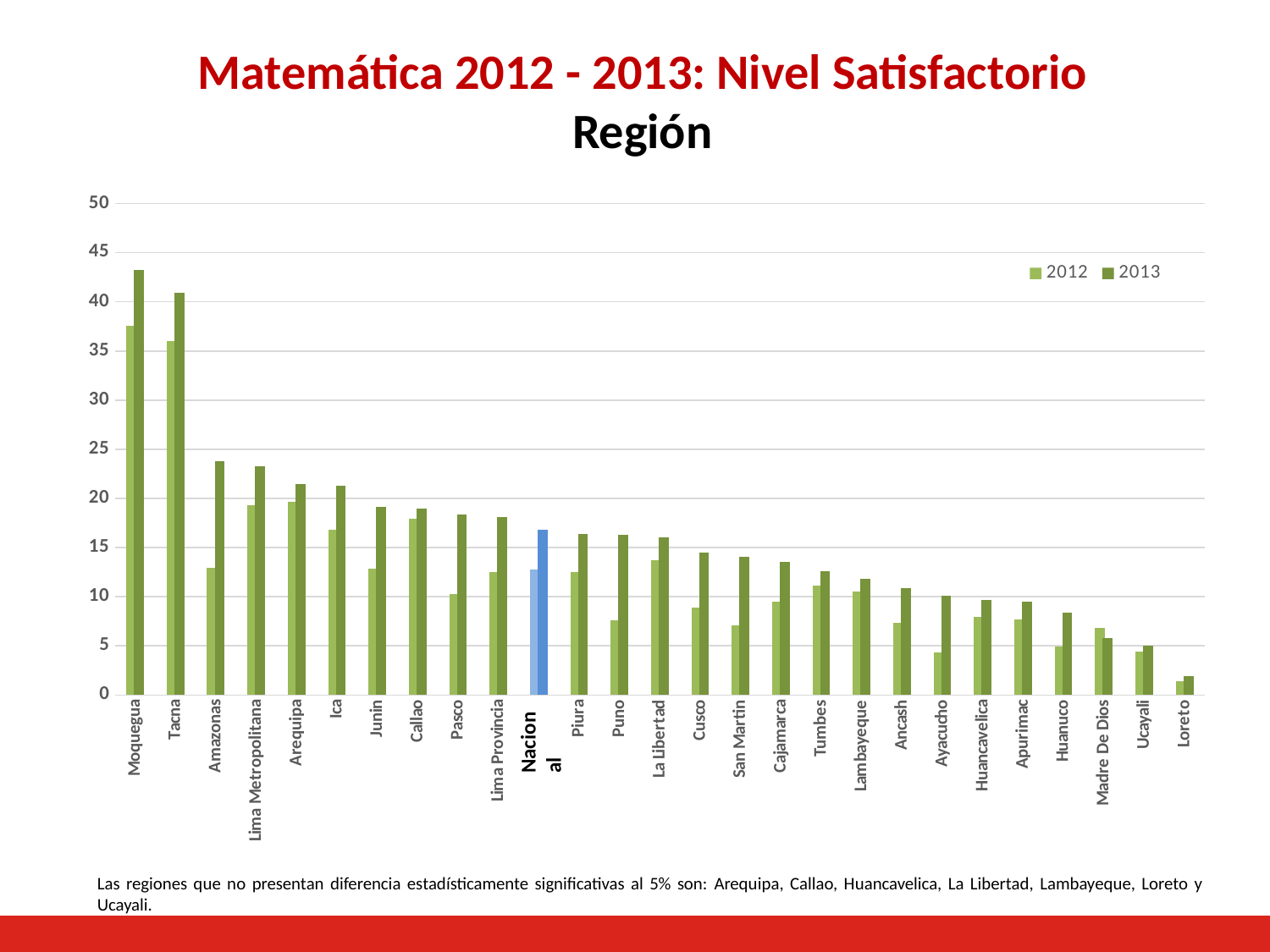
Which region has the lowest value for 2012? Loreto What is the title of the chart? Matemática 2012 - 2013: Nivel Satisfactorio Región Is the 2012 value for Ayacucho greater or less than 5? less Which region has the highest value for 2013? Moquegua Which region has the lowest value for 2013? Loreto Do the 2013 values generally rise or fall moving from left to right along the x axis? fall How many regions (categories) are shown on the x axis? 27 How many series does the legend list? 2 What kind of chart is shown on the slide? bar chart Is the 2013 value for Moquegua greater or less than 40? greater Is the 2013 value for Amazonas greater or less than 20? greater Which is larger for Amazonas: the 2012 value or the 2013 value? 2013